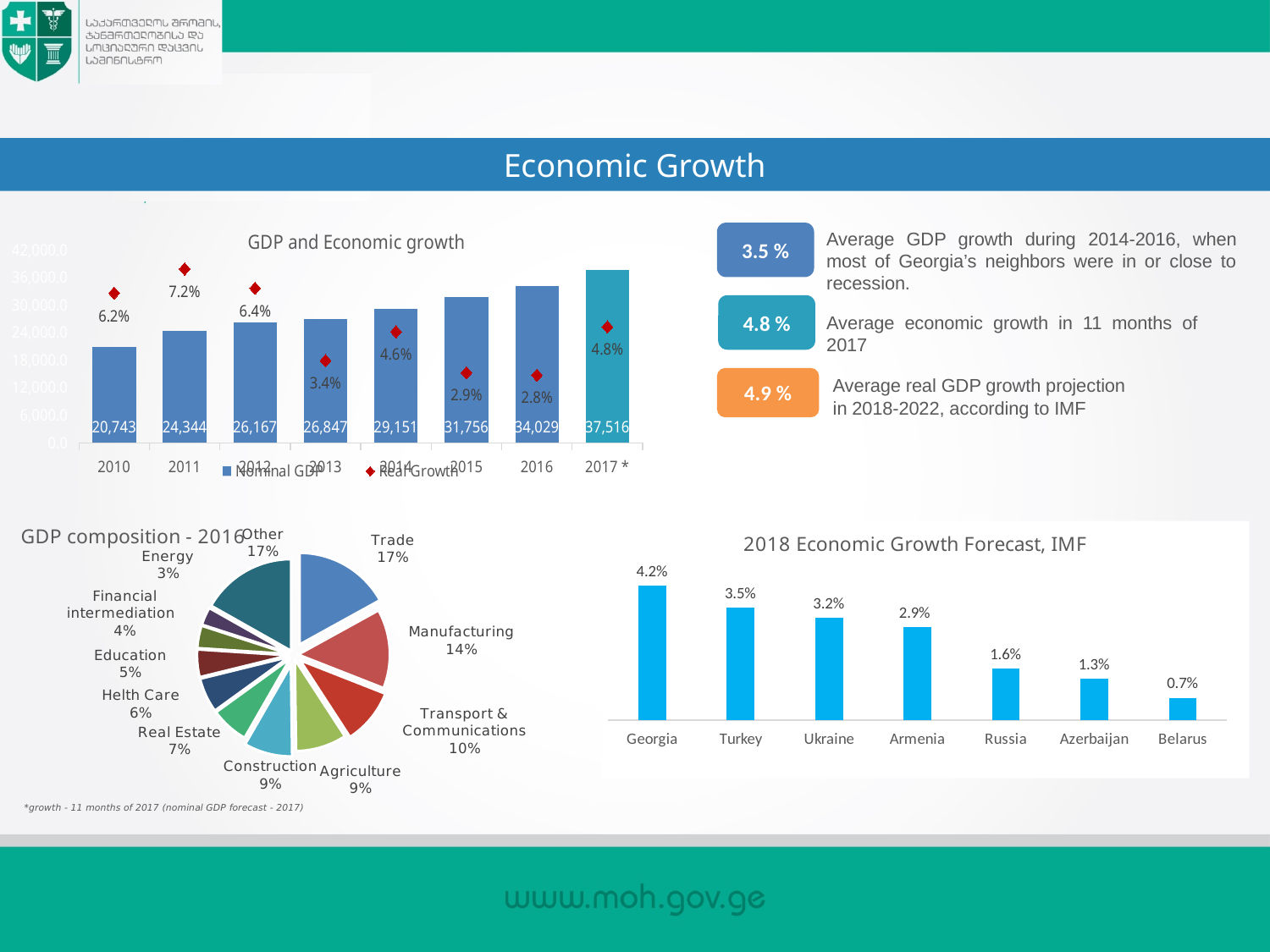
In the 'GDP composition - 2016' pie chart, which is larger, Education or Real Estate? Real Estate In the 'GDP composition - 2016' pie chart, what share does Manufacturing have? 14% In the 'GDP and Economic growth' chart, which year has the lowest real growth? 2016 In the '2018 Economic Growth Forecast, IMF' chart, what is the value for Azerbaijan? 1.3% In the 'GDP and Economic growth' chart, how many series does the legend list? 2 In the 'GDP and Economic growth' chart, do the nominal GDP values rise or fall from 2010 to 2017*? rise In the 'GDP and Economic growth' chart, what is the real growth value for 2011? 7.2% What kind of chart is the '2018 Economic Growth Forecast, IMF' chart? bar chart In the 'GDP and Economic growth' chart, what is the difference in nominal GDP between 2017* and 2010? 16,773 In the 'GDP and Economic growth' chart, what is the nominal GDP value for 2014? 29,151 In the '2018 Economic Growth Forecast, IMF' chart, which country has the highest forecast? Georgia In the 'GDP composition - 2016' pie chart, how many slices are there? 11